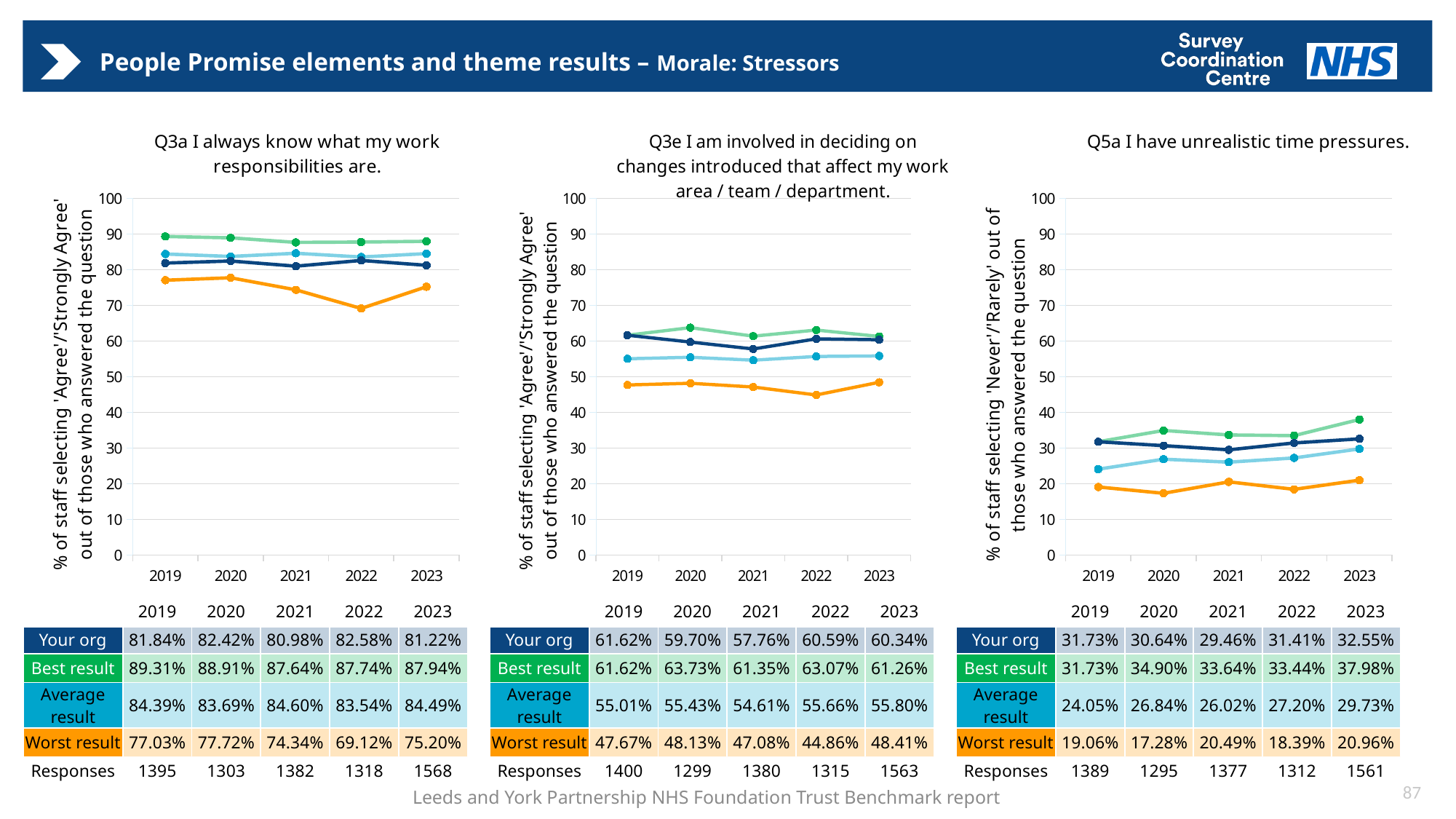
In the Q3a 'I always know what my work responsibilities are' chart, what is the difference between the Best result and Your org in 2023? 6.72 percentage points In the Q3a 'I always know what my work responsibilities are' chart, in which year is the Worst result lowest? 2022 In the Q3e 'I am involved in deciding on changes' chart, in which year is the Best result highest? 2020 In the Q3a 'I always know what my work responsibilities are' chart, what is the Your org value for 2022? 82.58% In the Q3e 'I am involved in deciding on changes' chart, is the Worst result for 2022 greater or less than 50? less In the Q5a 'I have unrealistic time pressures' chart, what is the Best result for 2023? 37.98% In the Q3e 'I am involved in deciding on changes' chart, what is the Average result for 2021? 54.61% In the Q5a 'I have unrealistic time pressures' chart, does the Average result rise or fall from 2019 to 2023? rise In the Q5a 'I have unrealistic time pressures' chart, what is the difference between Your org and the Worst result in 2023? 11.59 percentage points In the Q3e 'I am involved in deciding on changes' chart, is the Your org value higher in 2019 or 2023? 2019 What kind of chart is used for the Q3a 'I always know what my work responsibilities are' results? Line chart How many years are plotted on the x axis of the Q3e 'I am involved in deciding on changes' chart? 5